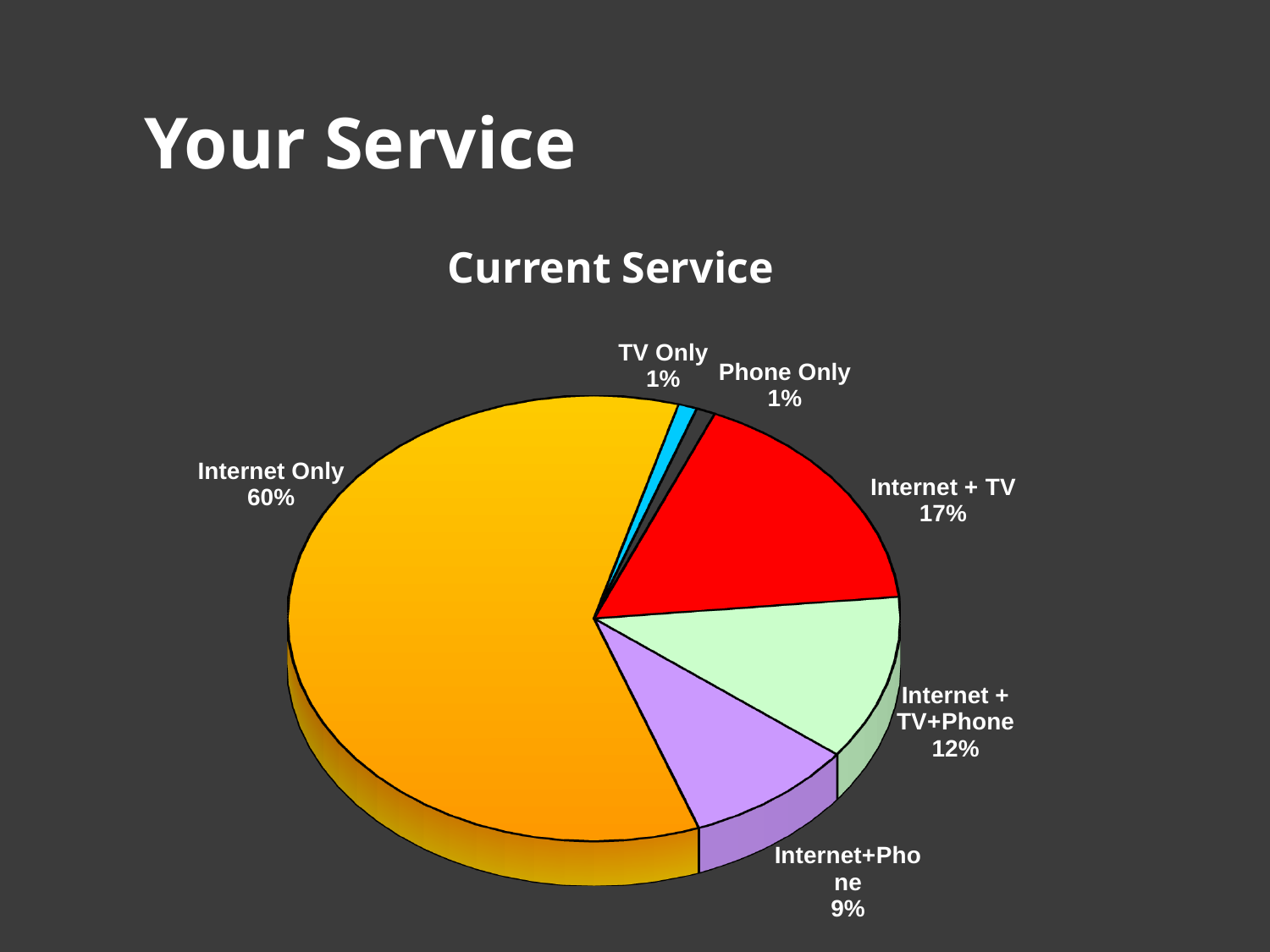
What is the difference between the Internet Only share and the Internet + TV share? 43% Which is larger, the Internet + TV+Phone share or the Internet+Phone share? Internet + TV+Phone What colour is the Internet + TV slice? Red What is the title of the chart? Current Service What share of the pie is TV Only? 1% How many slices does the pie chart have? 6 What share of the pie is Internet + TV+Phone? 12% What share of the pie is Internet + TV? 17% What kind of chart is shown on the slide? Pie chart Which category has the largest share of the pie? Internet Only What share of the pie is Internet Only? 60% What share of the pie is Internet+Phone? 9%